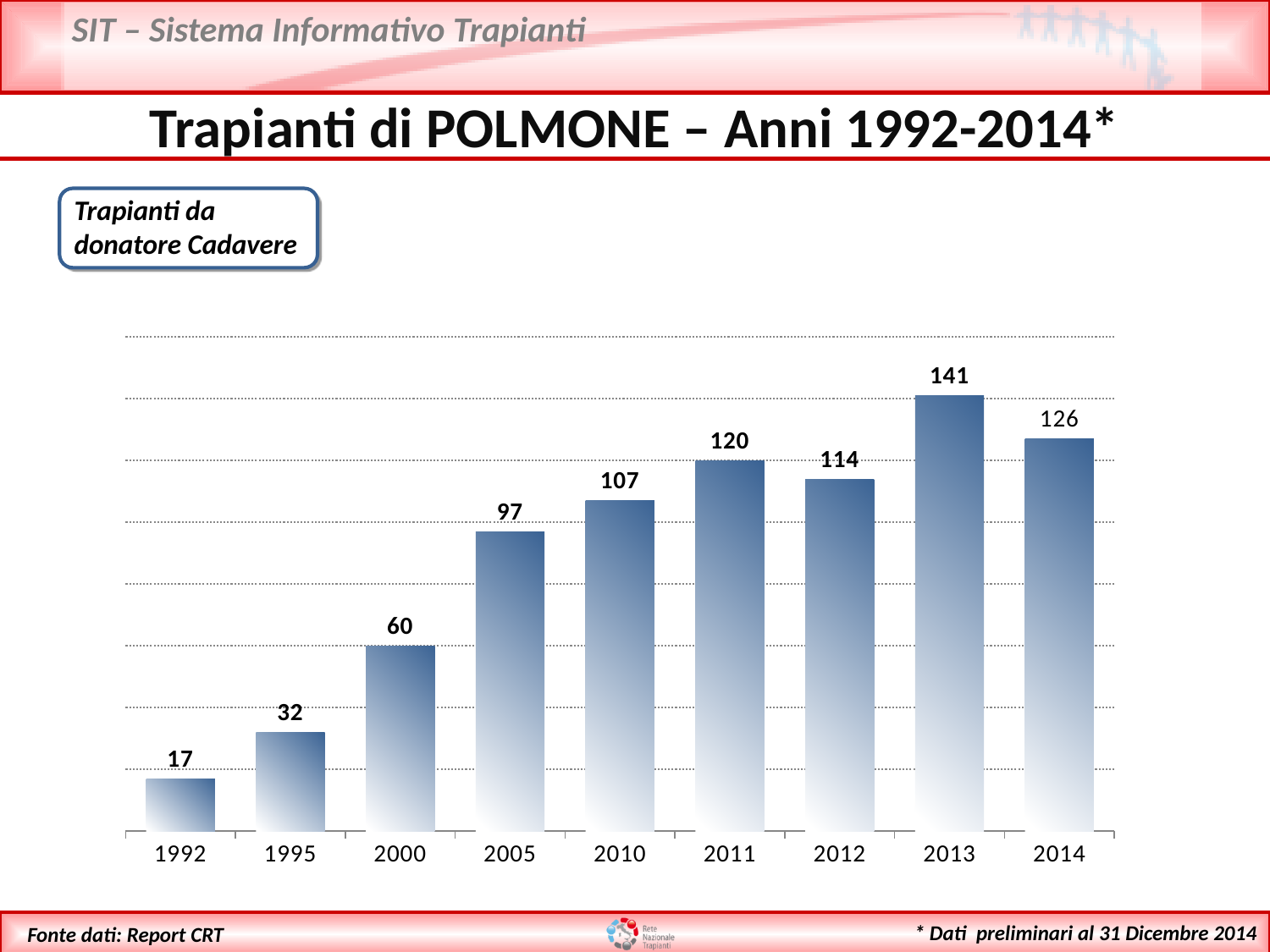
What kind of chart is shown on the slide? bar chart How many years are shown on the x axis? 9 What is the difference between the values for 2000 and 1995? 28 What is the difference between the values for 2013 and 2014? 15 What is the value shown for 1992? 17 Which is larger, the value for 2011 or the value for 2012? 2011 What is the title of the slide containing the chart? Trapianti di POLMONE – Anni 1992-2014* How many lung transplants were performed in 2005? 97 Which year has the lowest number of transplants? 1992 What is the value shown for 2014? 126 Do the values generally rise or fall from 1992 to 2013? rise Which year has the highest number of transplants? 2013